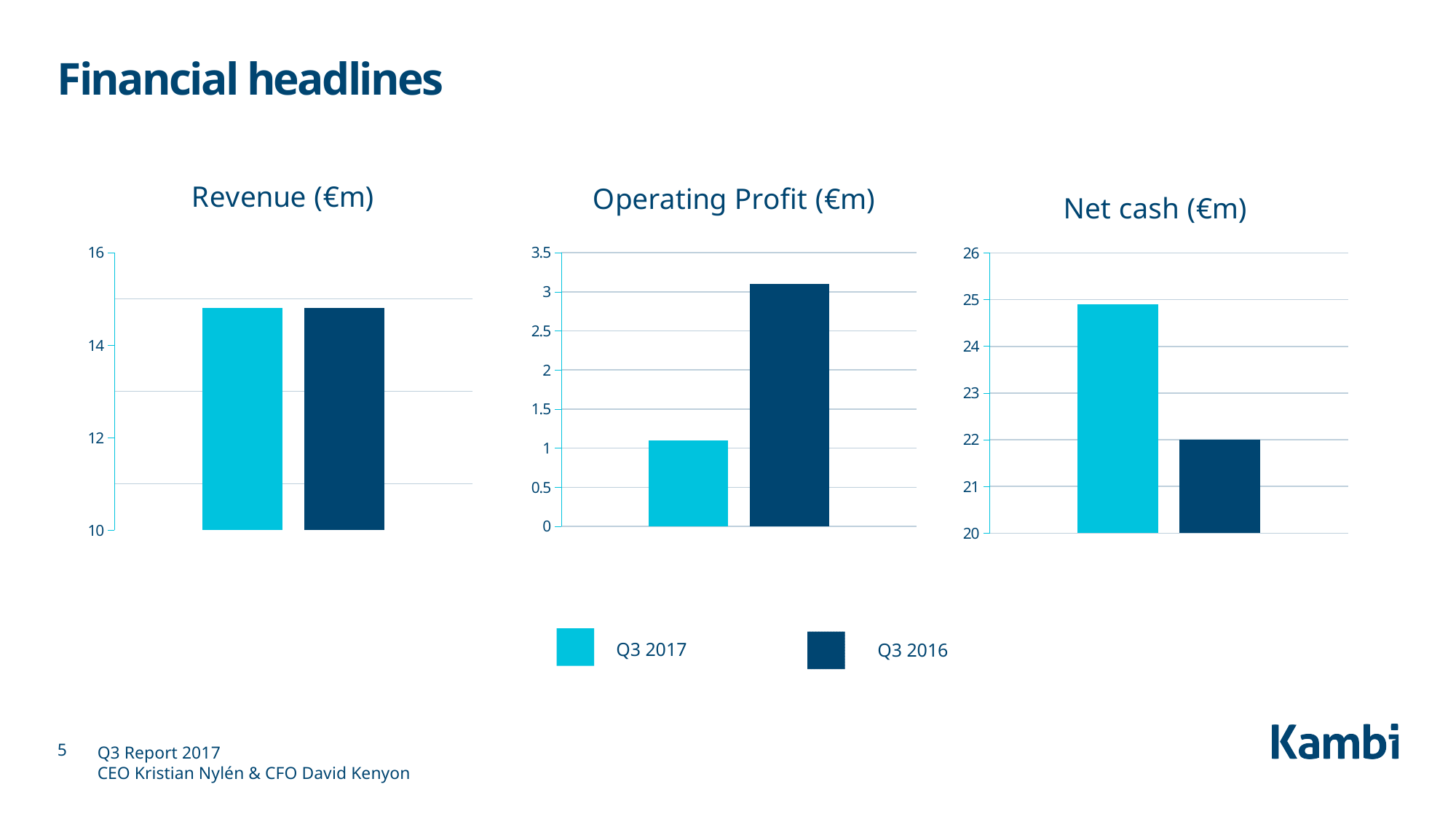
In the Net cash (€m) chart, which period has the higher value, Q3 2017 or Q3 2016? Q3 2017 In the Operating Profit (€m) chart, which period has the higher value, Q3 2017 or Q3 2016? Q3 2016 In the Operating Profit (€m) chart, is the value for Q3 2016 greater or less than 2.5? greater What kind of chart is the Revenue (€m) chart? bar chart In the Revenue (€m) chart, is the value for Q3 2017 greater or less than 14? greater How many bars are plotted in the Net cash (€m) chart? 2 How many series does the legend list? 2 In the Net cash (€m) chart, what is the value for Q3 2016? 22 Which two periods are listed in the legend? Q3 2017 and Q3 2016 In the Operating Profit (€m) chart, is the value for Q3 2017 greater or less than 1.5? less How many charts are shown on the slide? 3